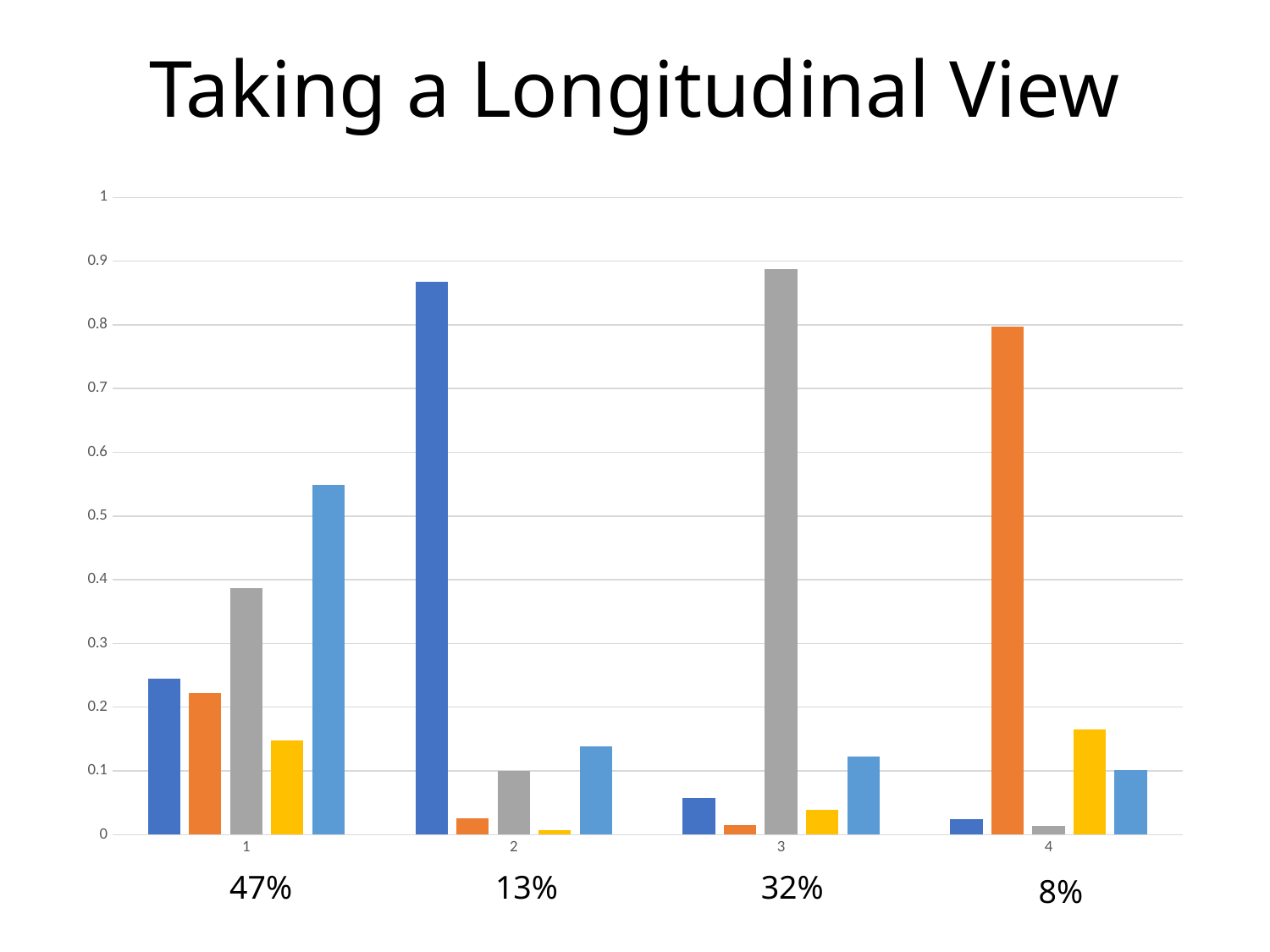
Is the value of the light blue bar in category 1 greater or less than 0.5? greater Which bar is the tallest in category 4? the orange bar What kind of chart is shown on the slide? bar chart What is the title of the slide containing the chart? Taking a Longitudinal View Is the value of the dark blue bar in category 2 greater or less than 0.8? greater Which bar is the shortest in category 2? the yellow bar How many categories are shown on the x axis of the chart? 4 Which is larger: the light blue bar in category 1 or the light blue bar in category 2? the light blue bar in category 1 Which bar is the tallest in category 3? the gray bar Is the value of the orange bar in category 4 greater or less than 0.7? greater Which bar is the tallest in category 2? the dark blue bar How many bars are plotted for each category in the chart? 5